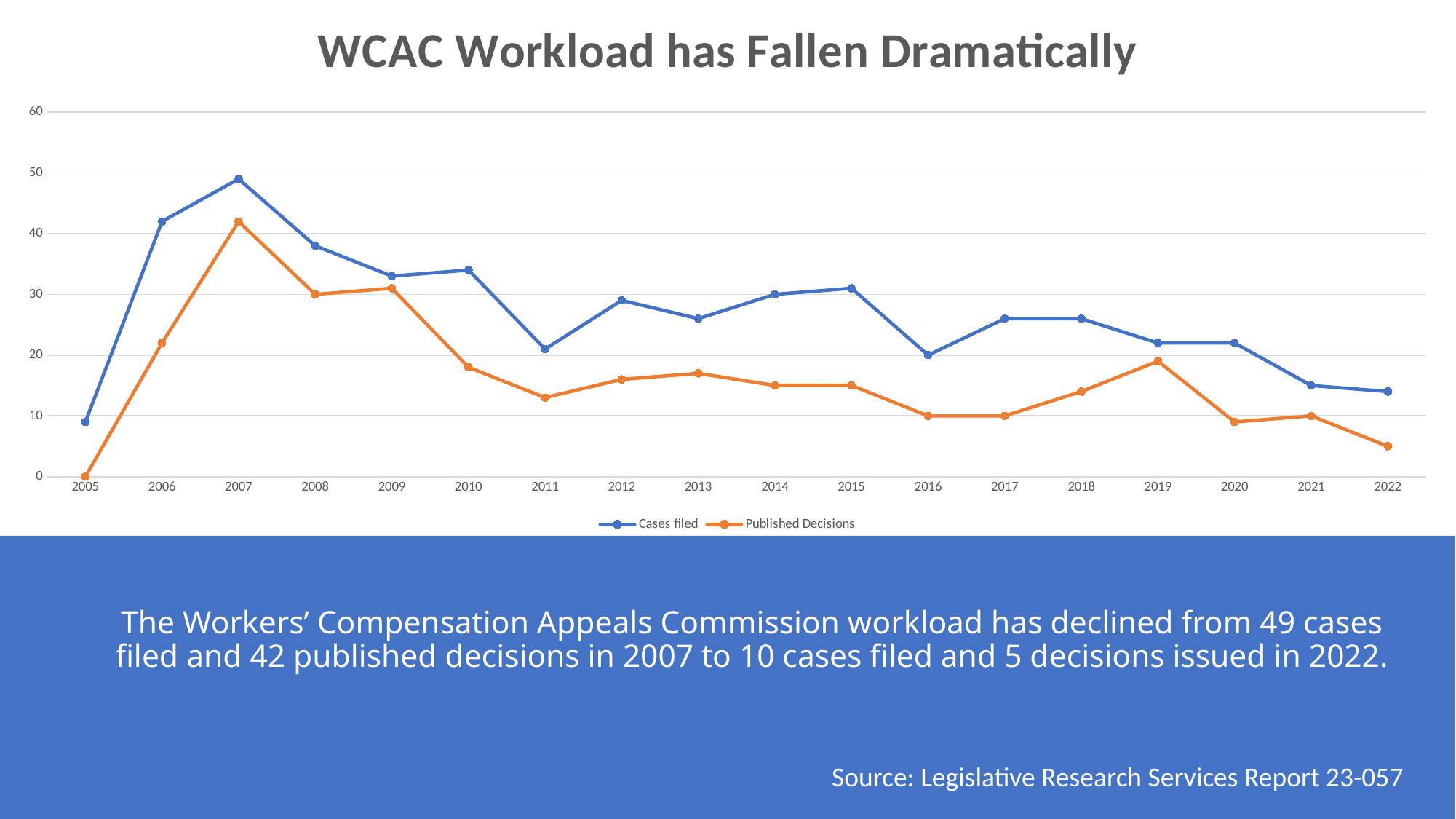
In which year was the number of published decisions lowest? 2005 How many series does the legend list? 2 What colour is the Cases filed line? Blue How many published decisions were there in 2007? 42 What kind of chart is shown on the slide? Line chart In 2010, which is larger: cases filed or published decisions? Cases filed In which year was the number of cases filed highest? 2007 How many published decisions were there in 2022? 5 Is the value for cases filed in 2006 greater or less than 40? greater What is the difference between cases filed and published decisions in 2007? 7 How many cases were filed in 2007? 49 How many years are plotted along the x axis? 18